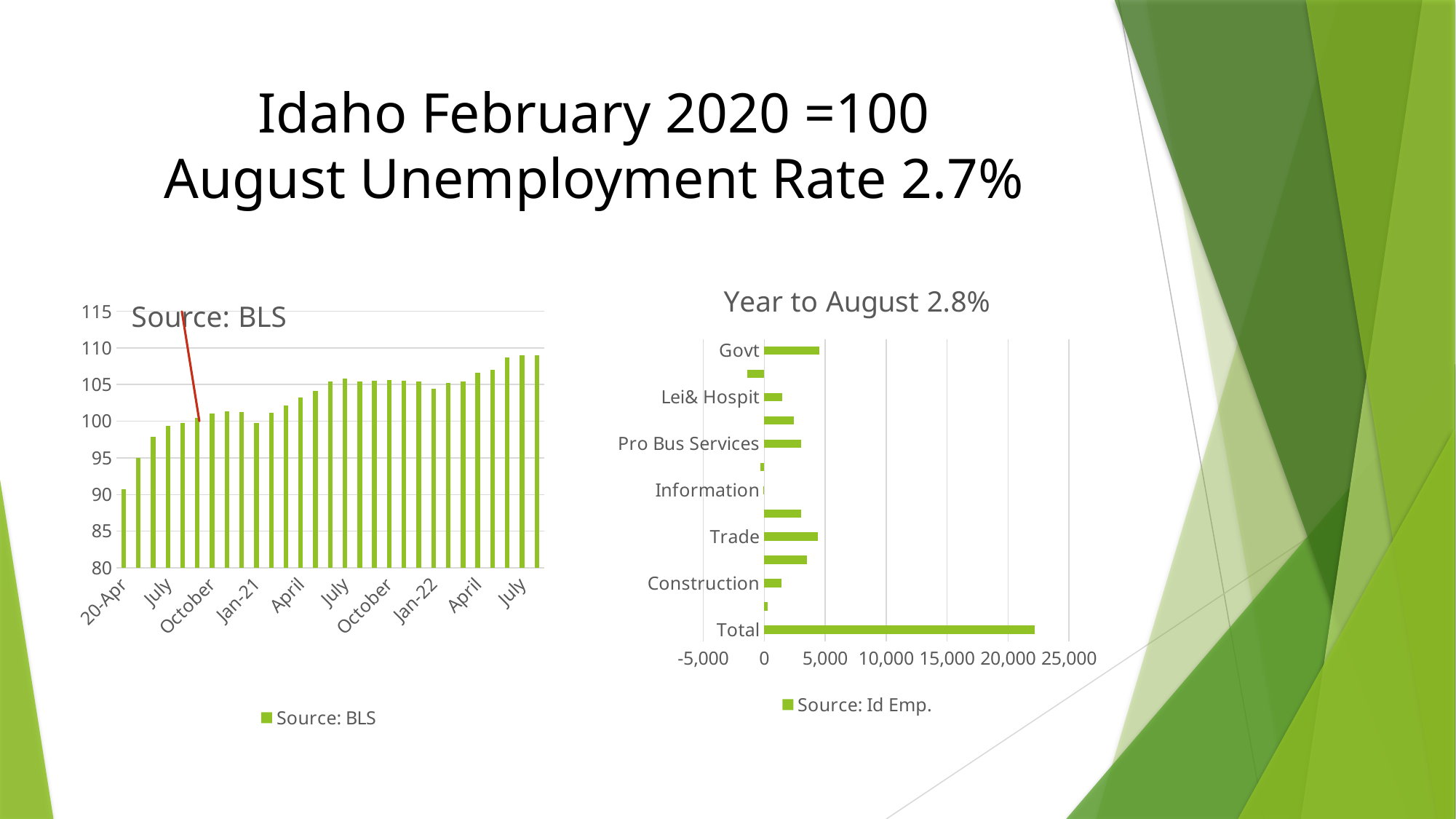
What kind of chart is the right chart titled 'Year to August 2.8%'? bar chart In the right chart 'Year to August 2.8%', is the value for Total greater or less than 20,000? greater What is the legend entry of the right chart 'Year to August 2.8%'? Source: Id Emp. In the left chart (Source: BLS), do the values generally rise or fall from 20-Apr to July 2022? rise What is the title of the right chart? Year to August 2.8% In the right chart 'Year to August 2.8%', which is larger, Trade or Construction? Trade In the left chart (Source: BLS), is the value for 20-Apr greater or less than 95? less In the left chart (Source: BLS), is the value for the last bar (July 2022) greater or less than 105? greater In the left chart (Source: BLS), which period has the lowest value? 20-Apr What kind of chart is the left chart with the legend 'Source: BLS'? bar chart In the right chart 'Year to August 2.8%', which category has the highest value? Total